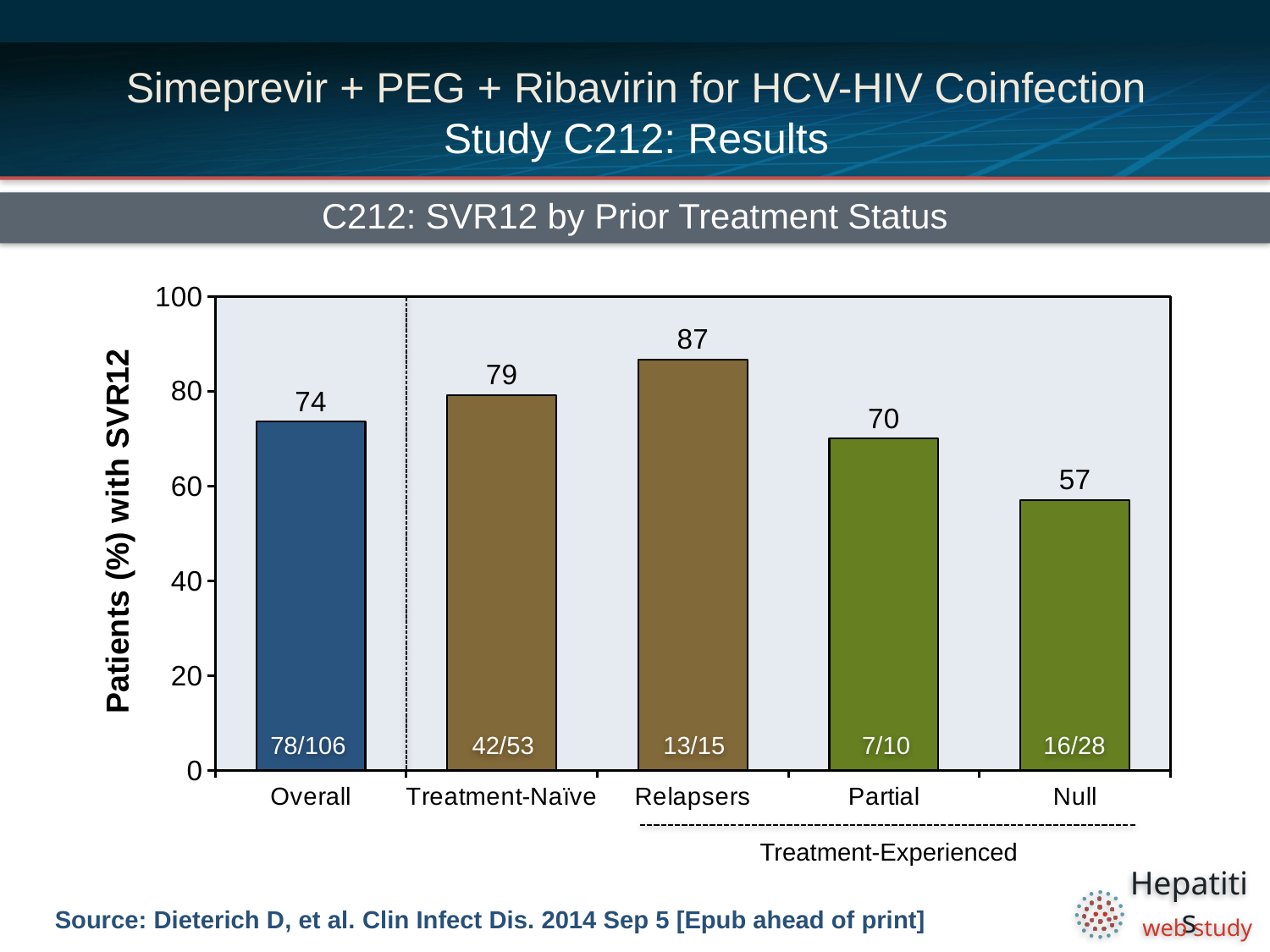
How many categories are shown on the x axis? 5 Is the SVR12 rate for Partial greater or less than 80? less What fraction of patients is shown inside the Treatment-Naïve bar? 42/53 What is the title of the chart? C212: SVR12 by Prior Treatment Status What is the SVR12 rate (%) for Relapsers? 87 What is the difference in SVR12 rate between Relapsers and Null? 30 Which has a higher SVR12 rate, Treatment-Naïve or Partial? Treatment-Naïve What is the SVR12 rate (%) for the Overall group? 74 Which category has the lowest SVR12 rate? Null Which category has the highest SVR12 rate? Relapsers What fraction of patients is shown inside the Null bar? 16/28 What kind of chart is shown on the slide? Bar chart